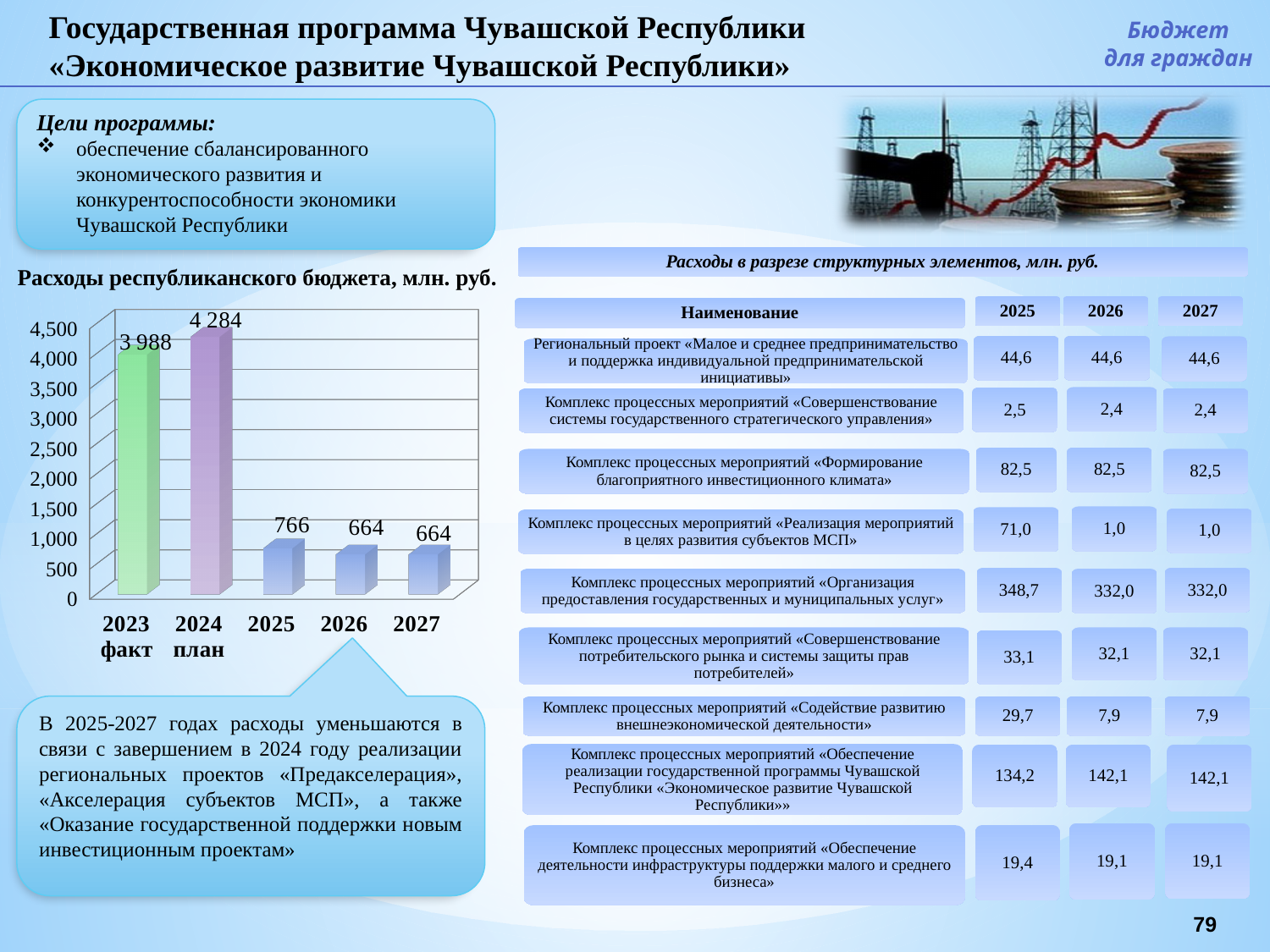
What kind of chart is 'Расходы республиканского бюджета, млн. руб.'? bar chart Which year has the highest value in the chart 'Расходы республиканского бюджета, млн. руб.'? 2024 Do the values in the chart 'Расходы республиканского бюджета, млн. руб.' rise or fall from 2024 to 2025? fall What is the value for 2024 in the chart 'Расходы республиканского бюджета, млн. руб.'? 4 284 What is the value for 2023 in the chart 'Расходы республиканского бюджета, млн. руб.'? 3 988 What is the difference between the values for 2025 and 2026 in the chart 'Расходы республиканского бюджета, млн. руб.'? 102 Is the value for 2025 in the chart 'Расходы республиканского бюджета, млн. руб.' greater or less than 1,000? less What is the value for 2027 in the chart 'Расходы республиканского бюджета, млн. руб.'? 664 Which is larger in the chart 'Расходы республиканского бюджета, млн. руб.': the value for 2023 or the value for 2025? 2023 What is the difference between the values for 2024 and 2023 in the chart 'Расходы республиканского бюджета, млн. руб.'? 296 What is the value for 2025 in the chart 'Расходы республиканского бюджета, млн. руб.'? 766 How many years are shown on the x axis of the chart 'Расходы республиканского бюджета, млн. руб.'? 5